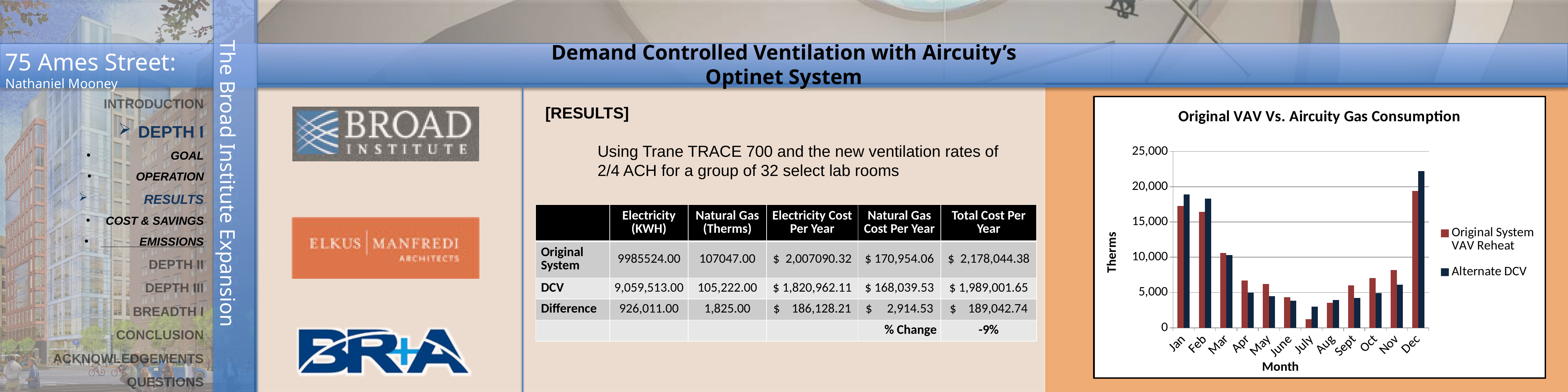
How many series does the legend of the 'Original VAV Vs. Aircuity Gas Consumption' chart list? 2 Is the Original System VAV Reheat value for Jan greater or less than 20,000 therms? less In Jan, which series has the larger value: Original System VAV Reheat or Alternate DCV? Alternate DCV Is the Original System VAV Reheat value for July greater or less than 5,000 therms? less In which month is the Original System VAV Reheat gas consumption lowest? July What kind of chart is shown on the slide? bar chart In which month is the Original System VAV Reheat gas consumption highest? Dec In Apr, which series has the larger value: Original System VAV Reheat or Alternate DCV? Original System VAV Reheat In which month is the Alternate DCV gas consumption highest? Dec What is the label on the y axis of the chart? Therms Is the Alternate DCV value for Dec greater or less than 20,000 therms? greater How many months are plotted on the x axis of the chart? 12